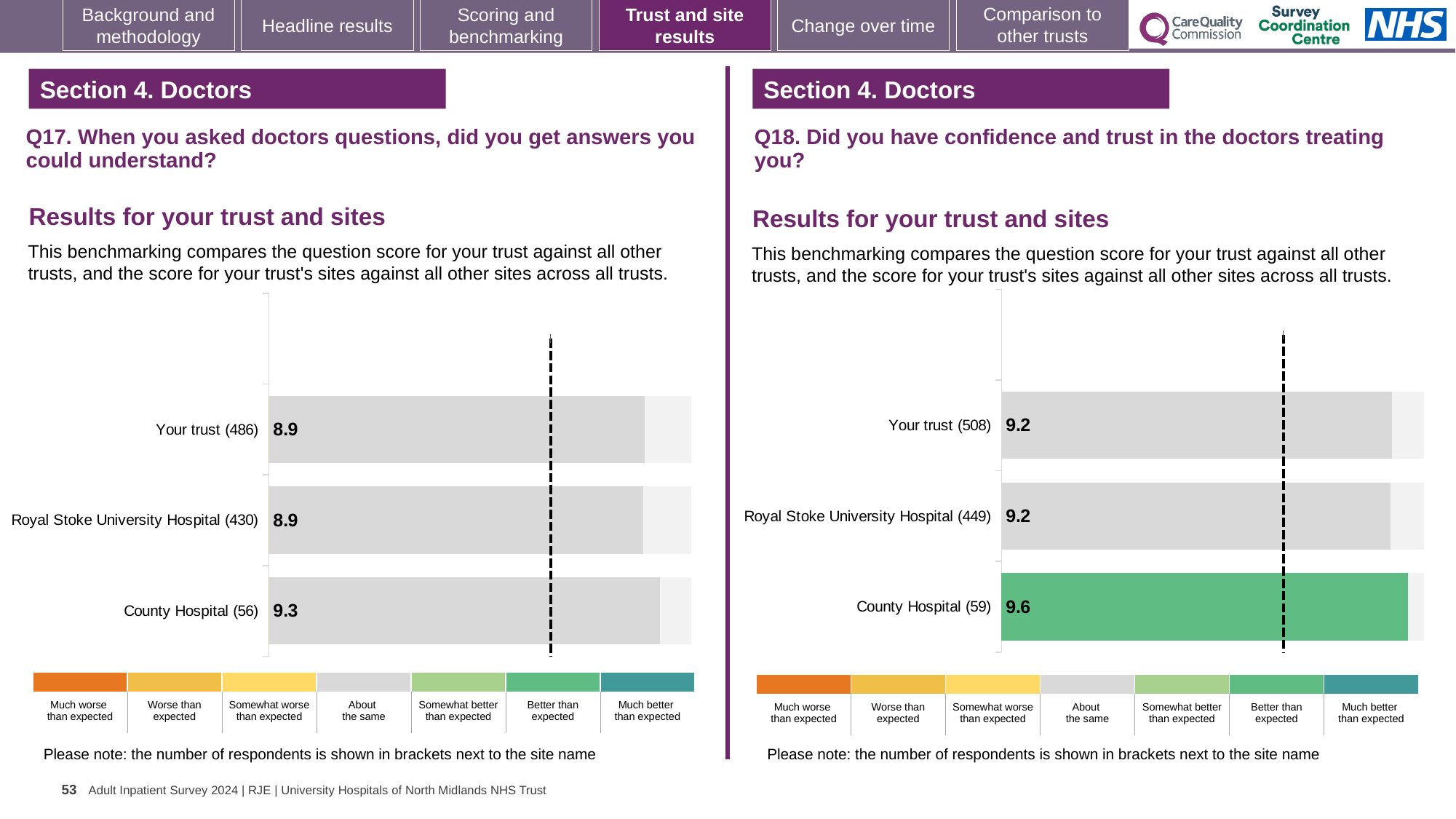
On the Q18 chart (right), what is the score for Royal Stoke University Hospital? 9.2 What kind of chart is used on the Q18 chart (right)? bar chart On the Q17 chart (left), what is the score for Your trust? 8.9 On the Q18 chart (right), which site or trust has the highest score? County Hospital On the Q17 chart (left), what is the score for County Hospital? 9.3 On the Q17 chart (left), how many bars are plotted? 3 On the Q18 chart (right), what is the difference between the County Hospital score and the Your trust score? 0.4 On the Q18 chart (right), is the score for County Hospital larger or smaller than the score for Your trust? larger On the Q18 chart (right), which benchmark category does the colour of the County Hospital bar correspond to in the legend? Better than expected On the Q17 chart (left), what is the difference between the County Hospital score and the Your trust score? 0.4 On the Q17 chart (left), which site or trust has the highest score? County Hospital On the Q18 chart (right), what is the score for County Hospital? 9.6